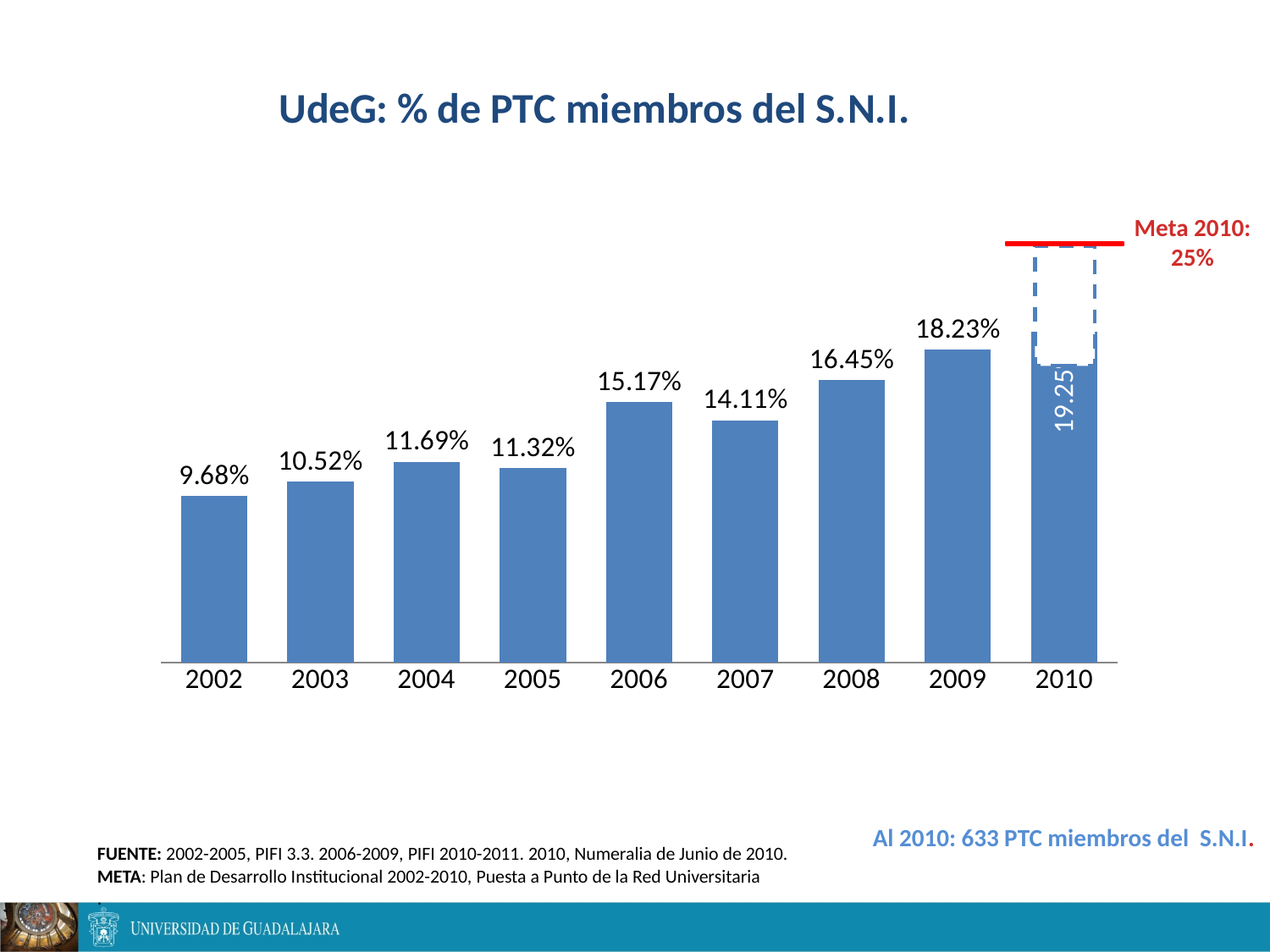
Which year has the lowest value? 2002 Which is larger, the value for 2006 or the value for 2007? 2006 What is the target (Meta) value shown for 2010? 25% How many years are shown on the x axis? 9 What is the difference between the values for 2009 and 2008? 1.78% Which is larger, the value for 2004 or the value for 2005? 2004 What is the value for 2006? 15.17% What is the value for 2009? 18.23% What is the value for 2007? 14.11% Which year has the highest bar? 2010 What kind of chart is this? Bar chart What is the value for 2002? 9.68%